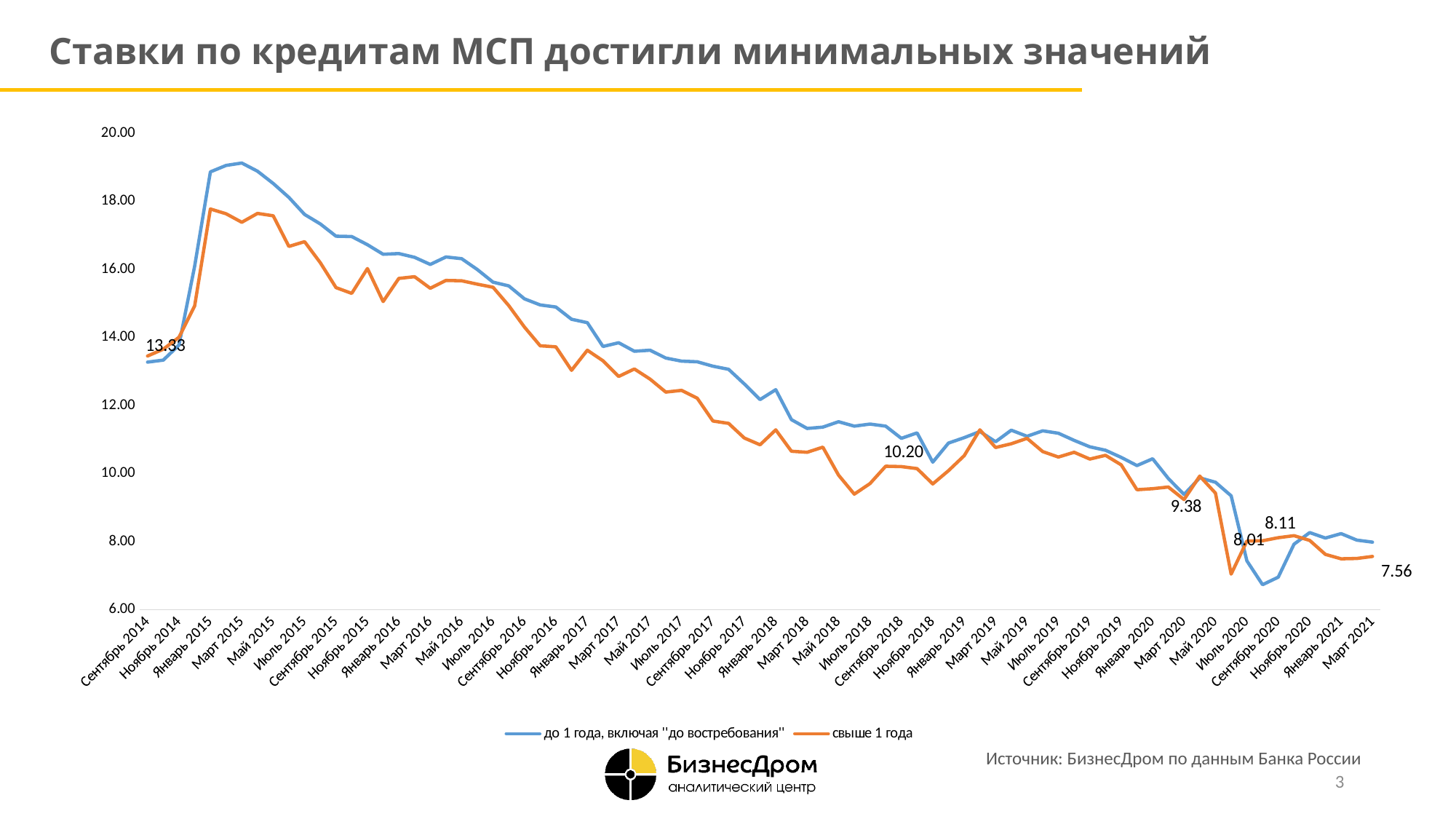
Is the value of the 'свыше 1 года' series at Июль 2020 greater or less than 8.00? greater Which series reaches the highest value on the chart? до 1 года, включая ''до востребования'' Which series is higher at Март 2015? до 1 года, включая ''до востребования'' What kind of chart is shown on the slide? line chart What is the title of the slide? Ставки по кредитам МСП достигли минимальных значений How many series does the legend list? 2 Do the rates generally rise or fall from Март 2015 to Март 2021? fall Is the value of the 'до 1 года, включая ''до востребования''' series at Сентябрь 2020 greater or less than 8.00? less Is the value of the 'до 1 года, включая ''до востребования''' series at Март 2015 greater or less than 18.00? greater What is the value labelled for the 'свыше 1 года' series at Март 2021? 7.56